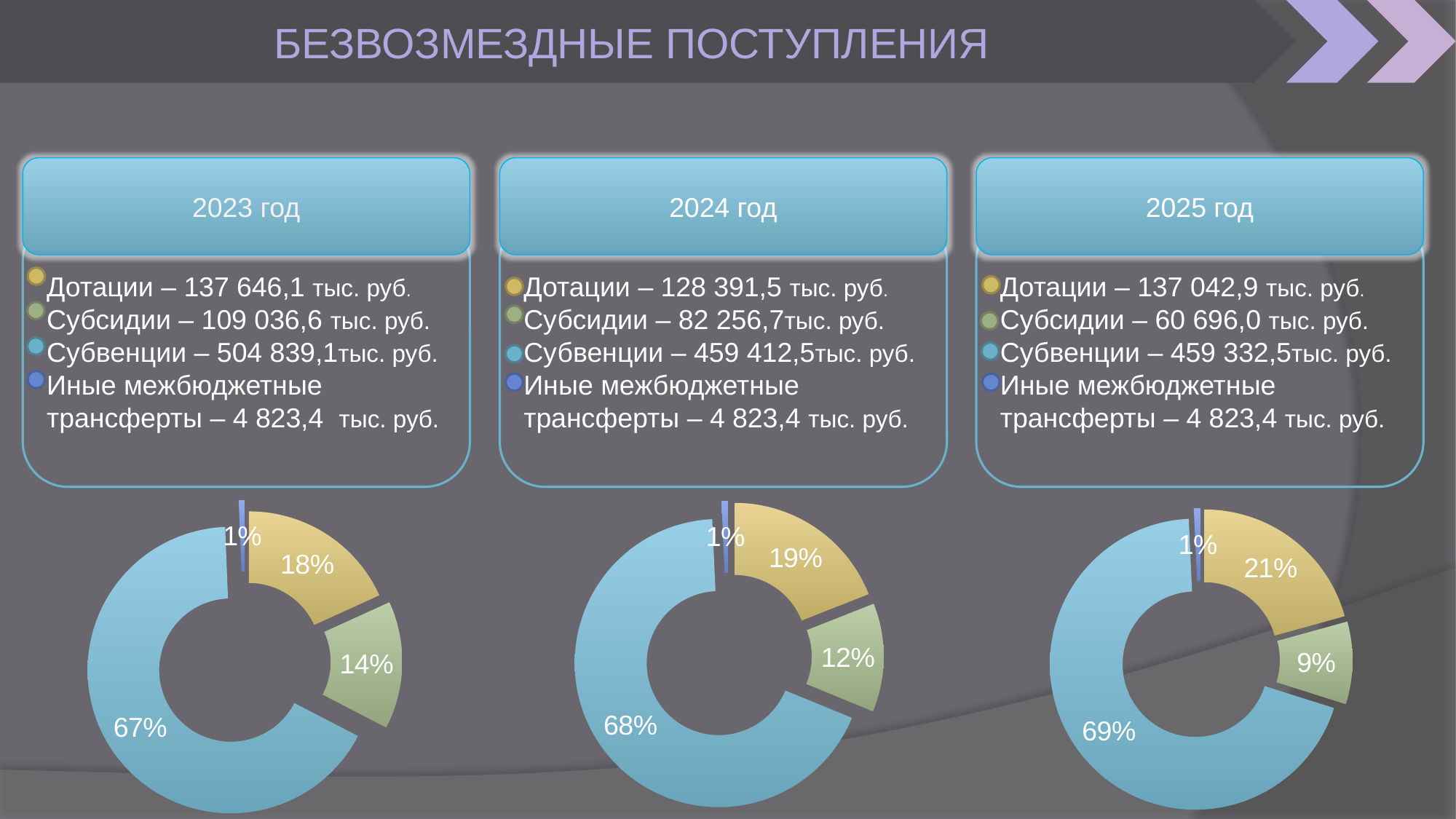
In the 2023 год chart, by how many percentage points does the Дотации share exceed the Субсидии share? 4 percentage points In the 2023 год chart, which category has the largest slice? Субвенции In the 2024 год chart, what share do Дотации make up? 19% What kind of chart is used for each year on this slide? Doughnut (pie) chart In the 2023 год chart, what share do Субвенции make up? 67% How many slices does the 2024 год chart have? 4 In the 2025 год chart, which slice is larger: Дотации or Субсидии? Дотации In the 2025 год chart, what share do Субсидии make up? 9% In the 2025 год chart, which category has the smallest slice? Иные межбюджетные трансферты How does the share of Субвенции change across the charts from 2023 to 2025? It rises (67%, 68%, 69%) How many charts are shown on the slide? 3